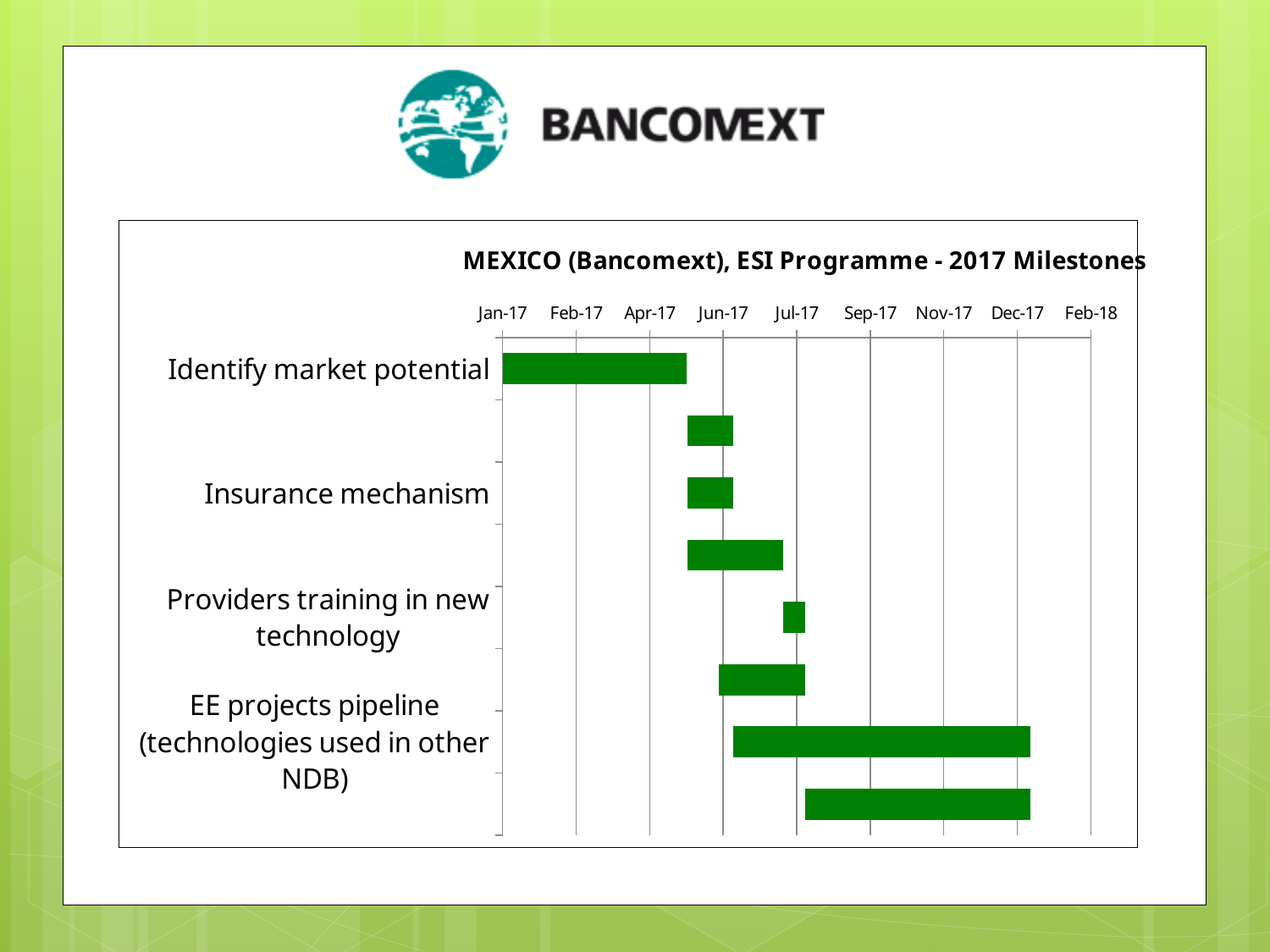
How many bars are plotted in the chart? 8 Which bar is longer: the one for Identify market potential or the one for Providers training in new technology? Identify market potential Does the bar for Identify market potential extend past Apr-17? Yes What is the first date label on the horizontal axis of the chart? Jan-17 Which task's bar starts earliest in the chart? Identify market potential What kind of chart is shown on the slide? Bar chart How many date labels are shown on the horizontal axis of the chart? 9 What is the title of the chart? MEXICO (Bancomext), ESI Programme - 2017 Milestones Which labelled task has the longest bar in the chart? EE projects pipeline (technologies used in other NDB) What colour are the bars in the chart? Green Does the bar for Identify market potential extend past Jun-17? No How many task labels are shown on the vertical axis of the chart? 4